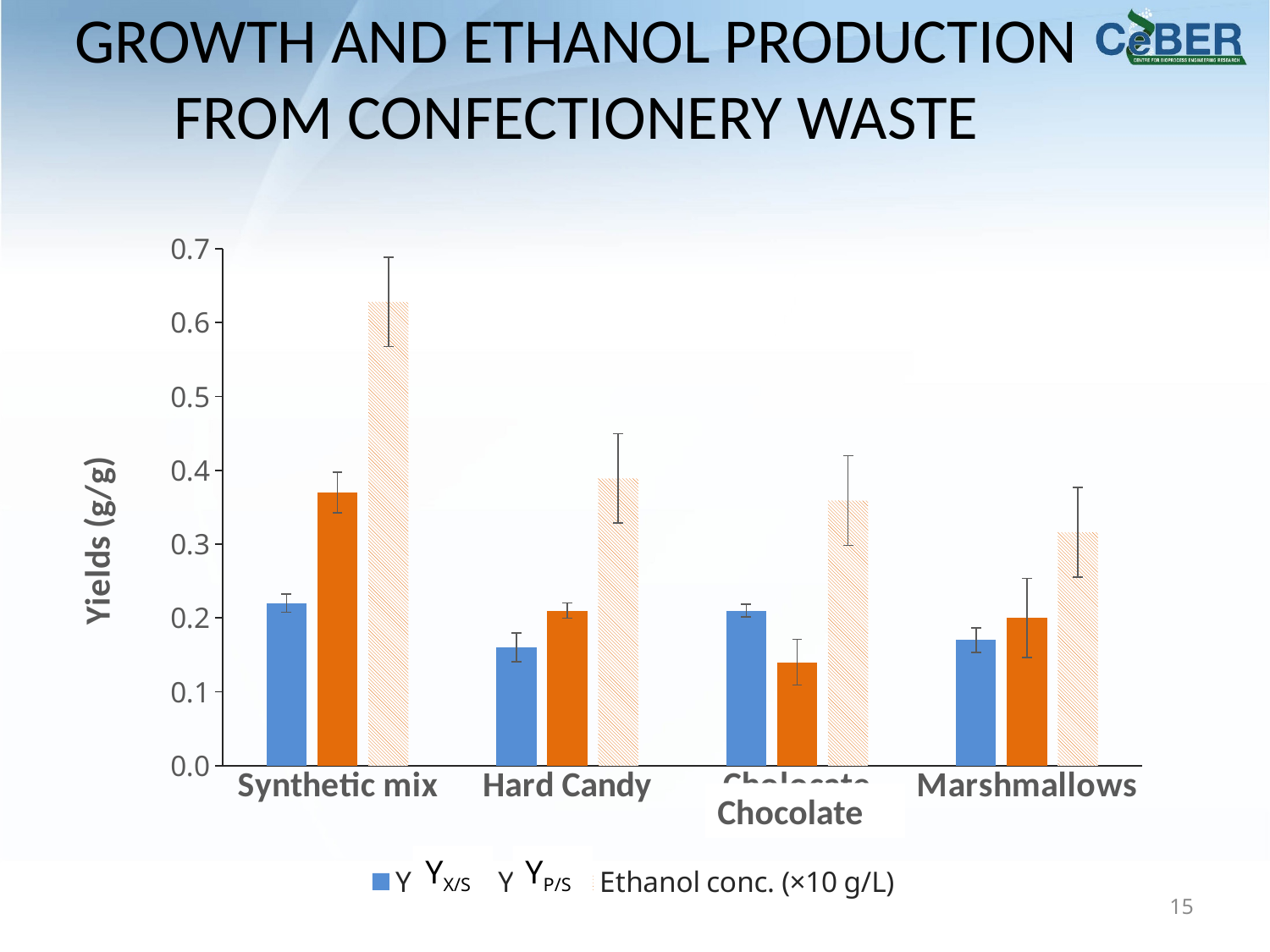
Is the Y X/S value for Hard Candy greater or less than 0.2? less Is the Ethanol conc. (×10 g/L) value for Synthetic mix greater or less than 0.5? greater How many series does the chart's legend list? 3 Which category has the highest Y P/S value? Synthetic mix Which category has the highest Ethanol conc. (×10 g/L) value? Synthetic mix Is the Y P/S value for Synthetic mix greater or less than 0.3? greater Which category has the lowest Y P/S value? Chocolate For Chocolate, which is larger: the Y X/S value or the Y P/S value? Y X/S What kind of chart is shown on the slide? bar chart What is the title of the chart's vertical axis? Yields (g/g) How many categories are shown on the x axis of the chart? 4 Which is larger: the Y P/S value for Synthetic mix or the Y P/S value for Hard Candy? Synthetic mix